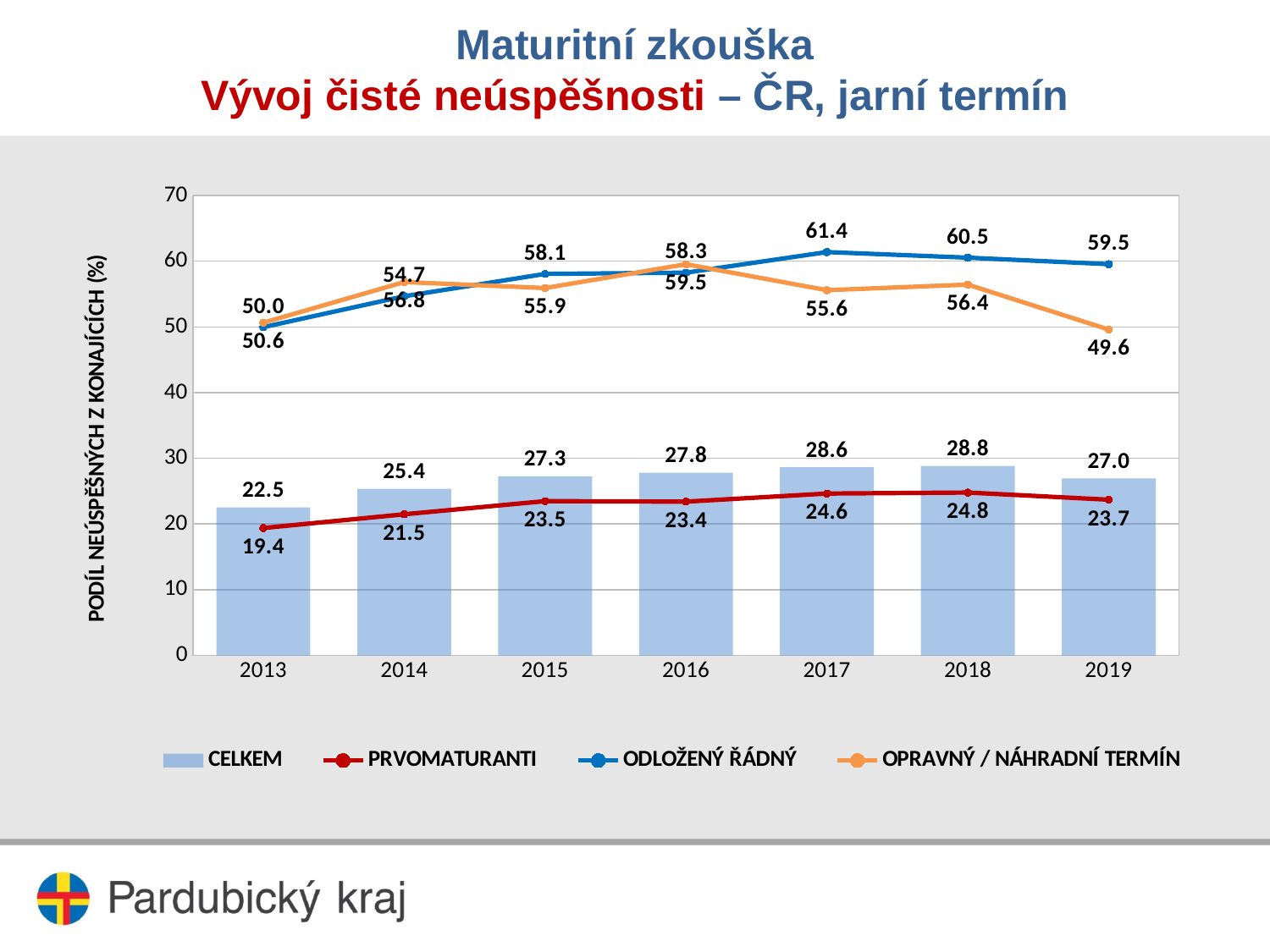
What is the value for PRVOMATURANTI in 2013? 19.4 How many series does the legend list? 4 What is the value for OPRAVNÝ / NÁHRADNÍ TERMÍN in 2019? 49.6 In 2017, which is larger: ODLOŽENÝ ŘÁDNÝ or OPRAVNÝ / NÁHRADNÍ TERMÍN? ODLOŽENÝ ŘÁDNÝ What is the value for ODLOŽENÝ ŘÁDNÝ in 2017? 61.4 What is the value for CELKEM in 2018? 28.8 In which year is the ODLOŽENÝ ŘÁDNÝ value highest? 2017 In which year is the CELKEM value highest? 2018 What kind of chart is this? Combined bar and line chart In which year is the PRVOMATURANTI value lowest? 2013 What is the difference between the CELKEM values for 2019 and 2013? 4.5 How many years are shown on the x axis? 7